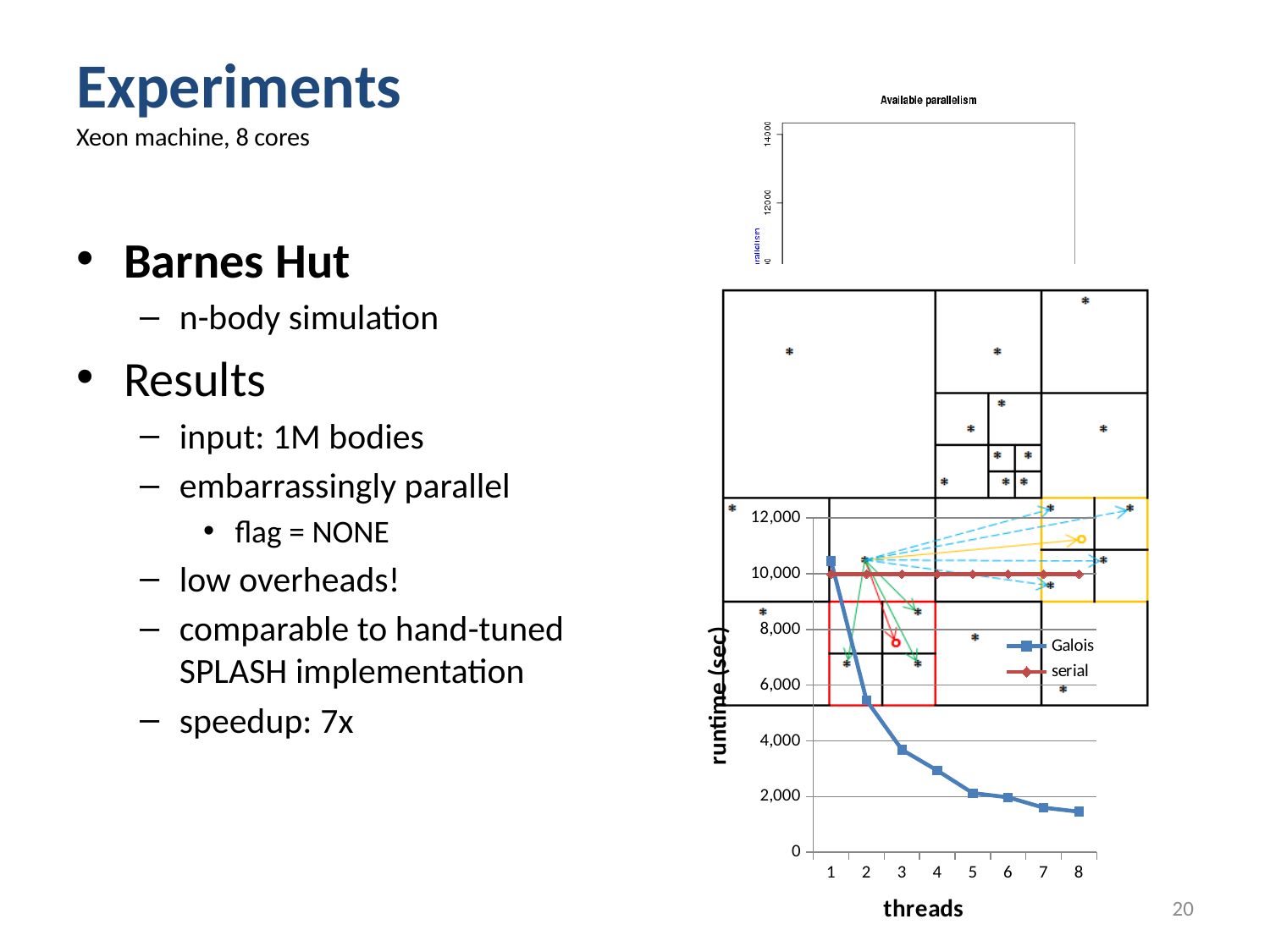
Is the Galois runtime at 4 threads greater or less than 4,000? less Does the Galois runtime rise or fall as the number of threads increases? fall What kind of chart is shown at the bottom right of the slide? line chart Is the Galois runtime at 1 thread greater or less than 8,000? greater At which thread count is the Galois runtime lowest? 8 What is the label of the x axis of the runtime chart? threads What are the two series named in the legend of the runtime chart? Galois and serial At 8 threads, which series has the higher runtime, Galois or serial? serial At which thread count is the Galois runtime highest? 1 How many series does the legend of the runtime chart list? 2 Is the Galois runtime at 8 threads greater or less than 2,000? less How many thread counts are plotted along the x axis of the runtime chart? 8